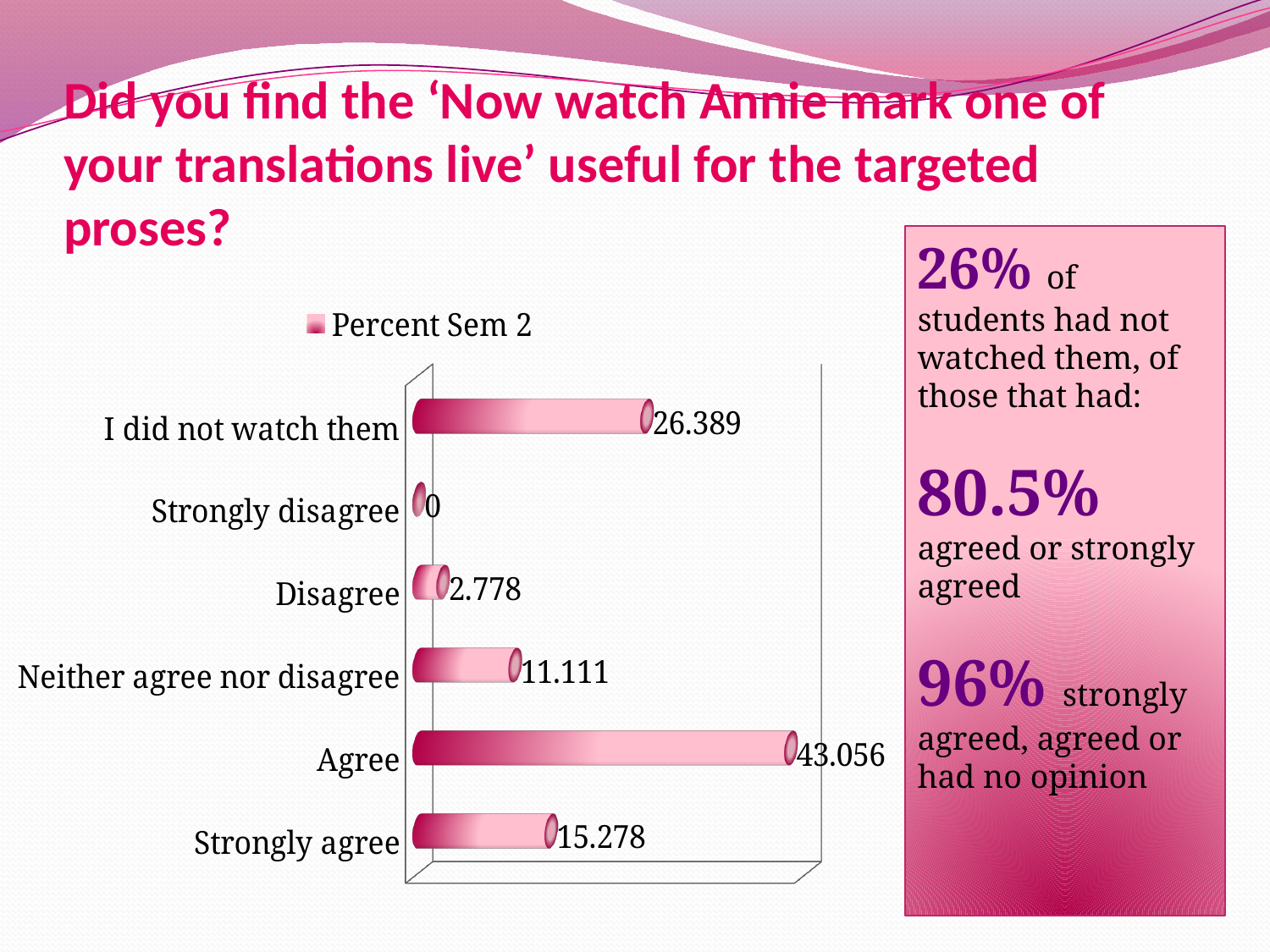
What is the name of the series shown in the legend? Percent Sem 2 What is the value for Disagree? 2.778 What is the value for Neither agree nor disagree? 11.111 How many series does the legend list? 1 How many categories are shown in the chart? 6 What is the value for Agree? 43.056 Which is larger, the value for I did not watch them or the value for Strongly agree? I did not watch them Which category has the lowest value? Strongly disagree What is the value for I did not watch them? 26.389 What kind of chart is shown on the slide? Bar chart Which category has the highest value? Agree What is the difference between the values for Agree and Strongly agree? 27.778